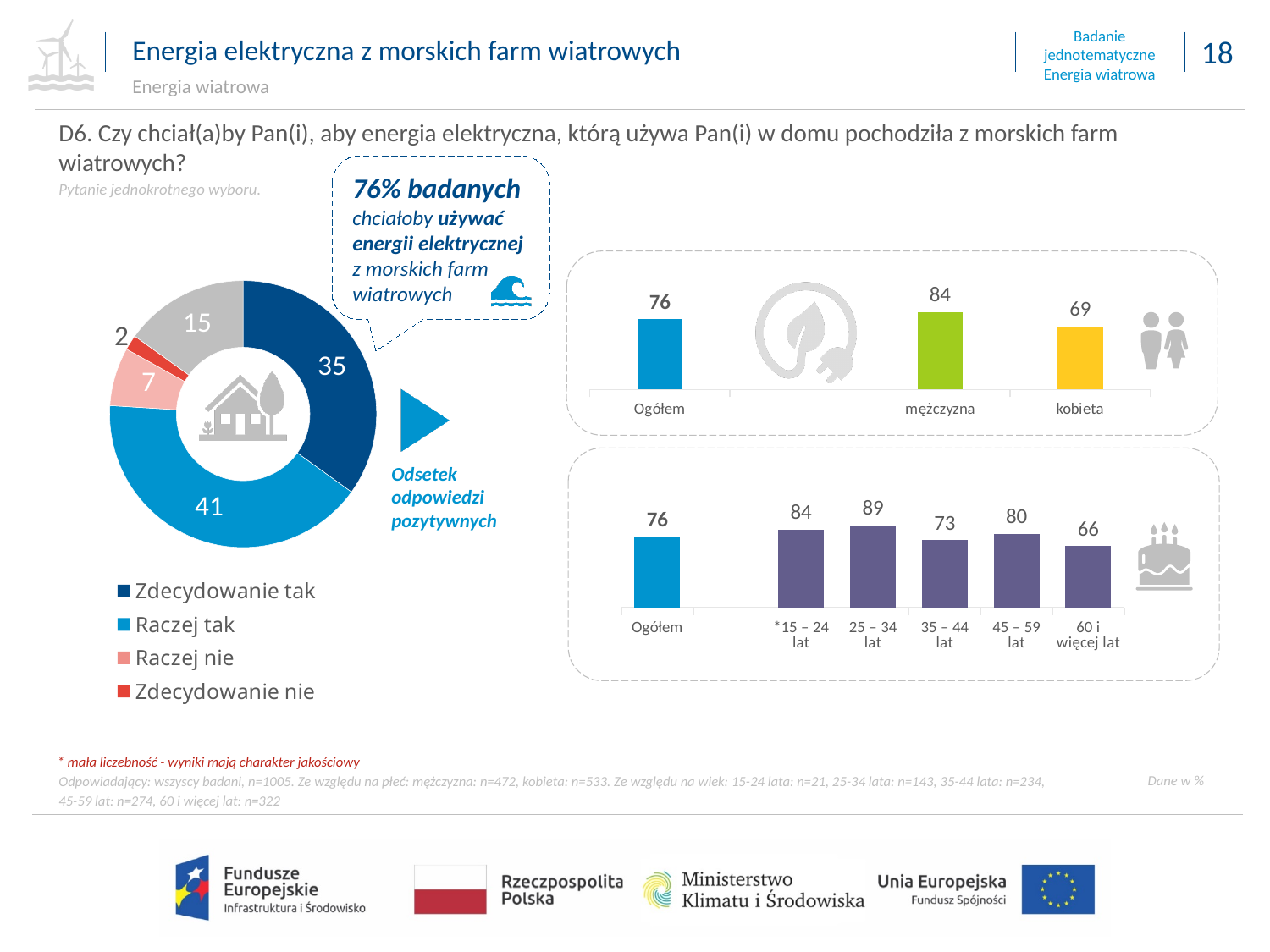
What type of chart is shown in the bottom-right panel (by age)? bar chart In the bottom-right bar chart (by age), what is the value for "45 – 59 lat"? 80 In the top-right bar chart (by gender), what is the value for "mężczyzna"? 84 In the donut chart on the left, which legend category has the largest value? Raczej tak In the top-right bar chart (by gender), what is the difference between the values for "mężczyzna" and "kobieta"? 15 In the donut chart on the left, what is the value for "Zdecydowanie tak"? 35 In the donut chart on the left, how many entries does the legend list? 4 In the bottom-right bar chart (by age), which age group has the lowest value? 60 i więcej lat In the donut chart on the left, what is the value for "Zdecydowanie nie"? 2 In the top-right bar chart (by gender), which is larger, "mężczyzna" or "kobieta"? mężczyzna In the donut chart on the left, what is the value for "Raczej tak"? 41 In the bottom-right bar chart (by age), which age group has the highest value? 25 – 34 lat